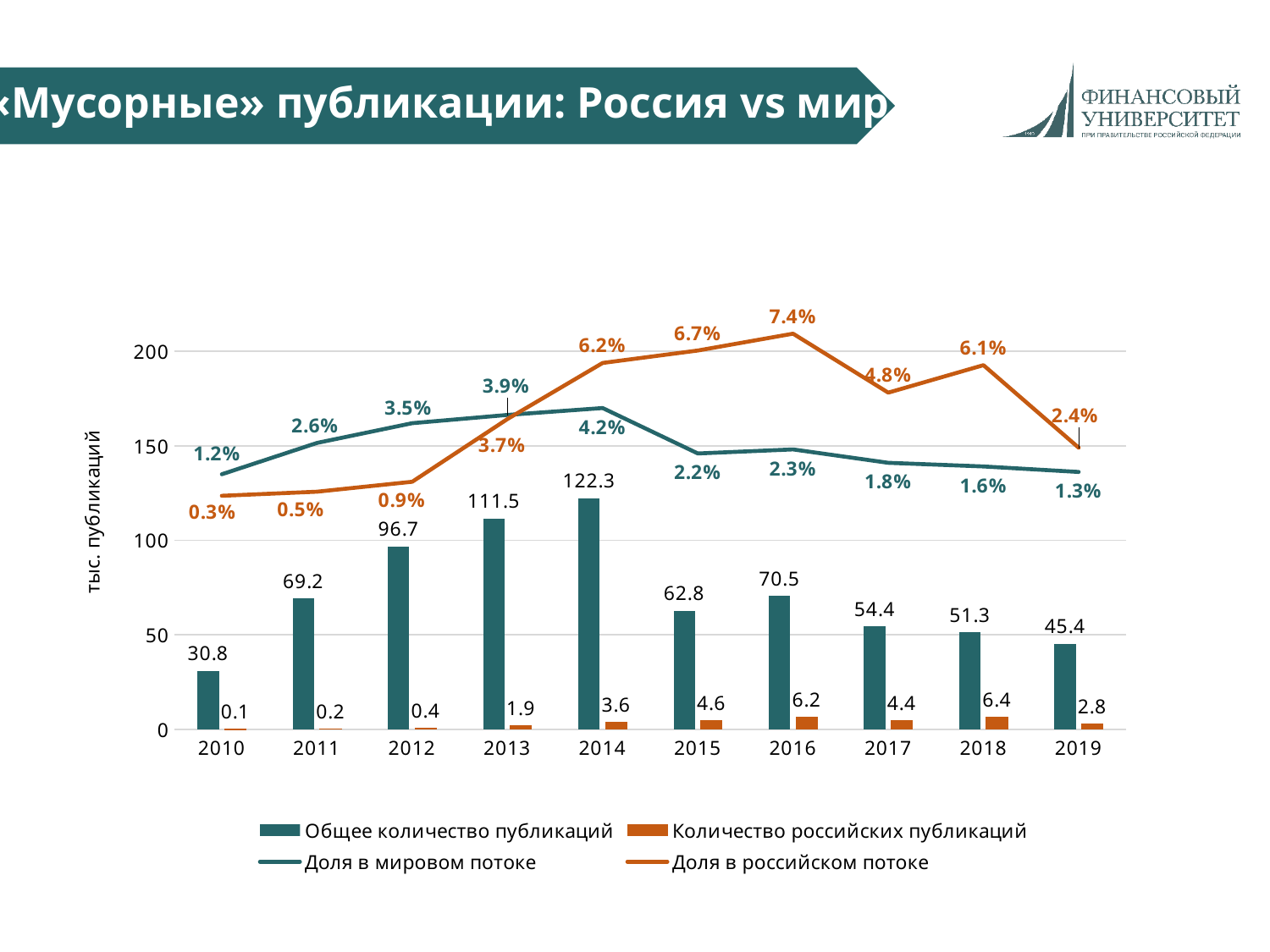
In which year is «Количество российских публикаций» lowest? 2010 Which is larger: «Общее количество публикаций» in 2016 or in 2011? 2016 What is the value of «Доля в мировом потоке» for 2013? 3.9% What is the value of «Количество российских публикаций» for 2018? 6.4 How many series does the legend list? 4 In which year is «Общее количество публикаций» highest? 2014 What is the difference between «Общее количество публикаций» in 2014 and in 2019? 76.9 Does «Доля в мировом потоке» rise or fall from 2014 to 2019? fall What is the value of «Общее количество публикаций» for 2014? 122.3 What is the label of the vertical axis? тыс. публикаций What is the value of «Доля в российском потоке» for 2016? 7.4% How many years are shown on the x axis? 10